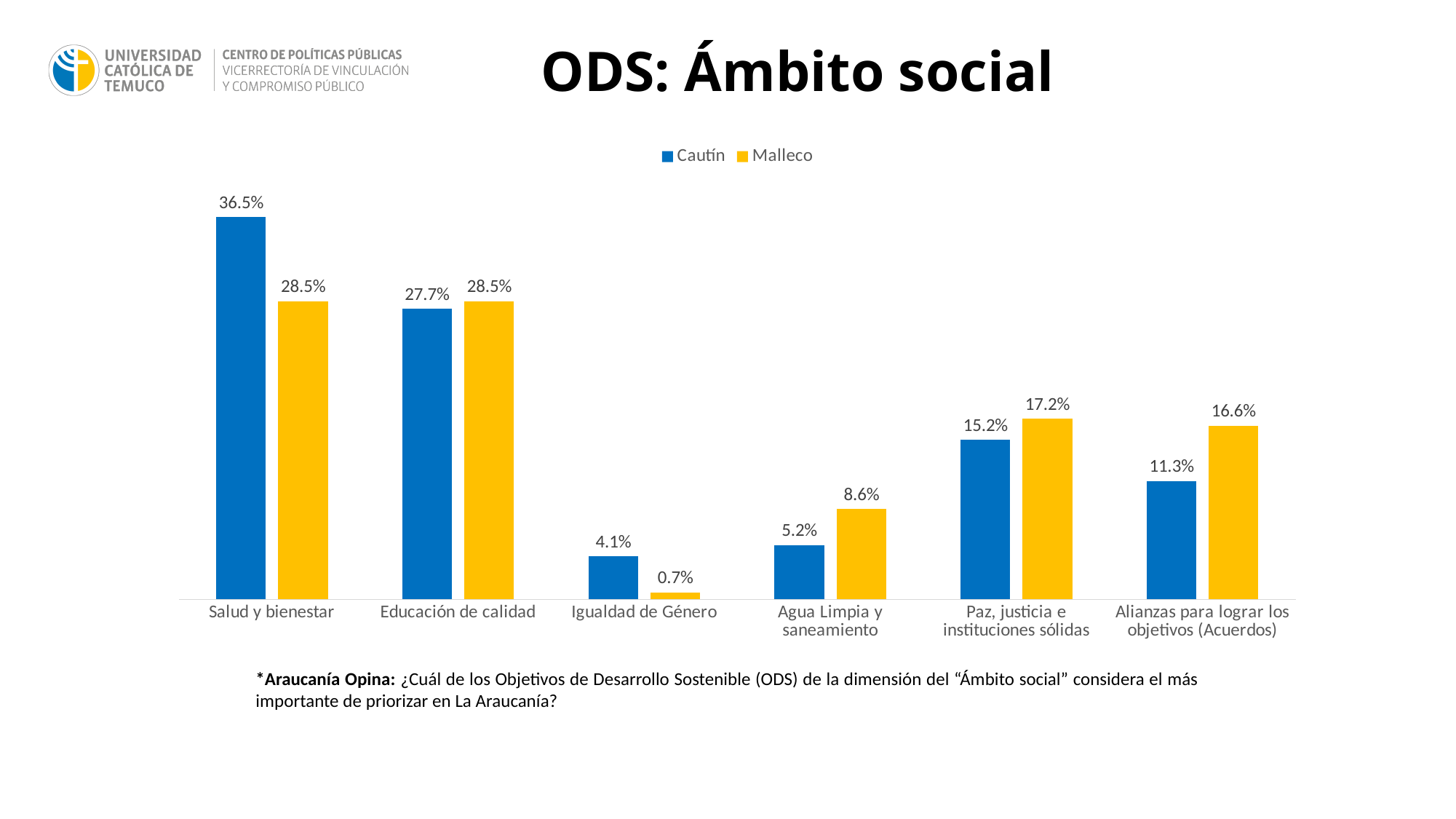
Which is larger for Paz, justicia e instituciones sólidas: the Cautín value or the Malleco value? Malleco What is the Malleco value for Agua Limpia y saneamiento? 8.6% How many series does the legend list? 2 Which category has the lowest Malleco value? Igualdad de Género Which colour represents the Malleco series? Yellow What is the difference between the Cautín and Malleco values for Salud y bienestar? 8.0% What kind of chart is shown on the slide? Bar chart What is the Cautín value for Alianzas para lograr los objetivos (Acuerdos)? 11.3% Which category has the highest Cautín value? Salud y bienestar What is the Cautín value for Salud y bienestar? 36.5% How many categories are shown on the x axis? 6 What is the Malleco value for Igualdad de Género? 0.7%